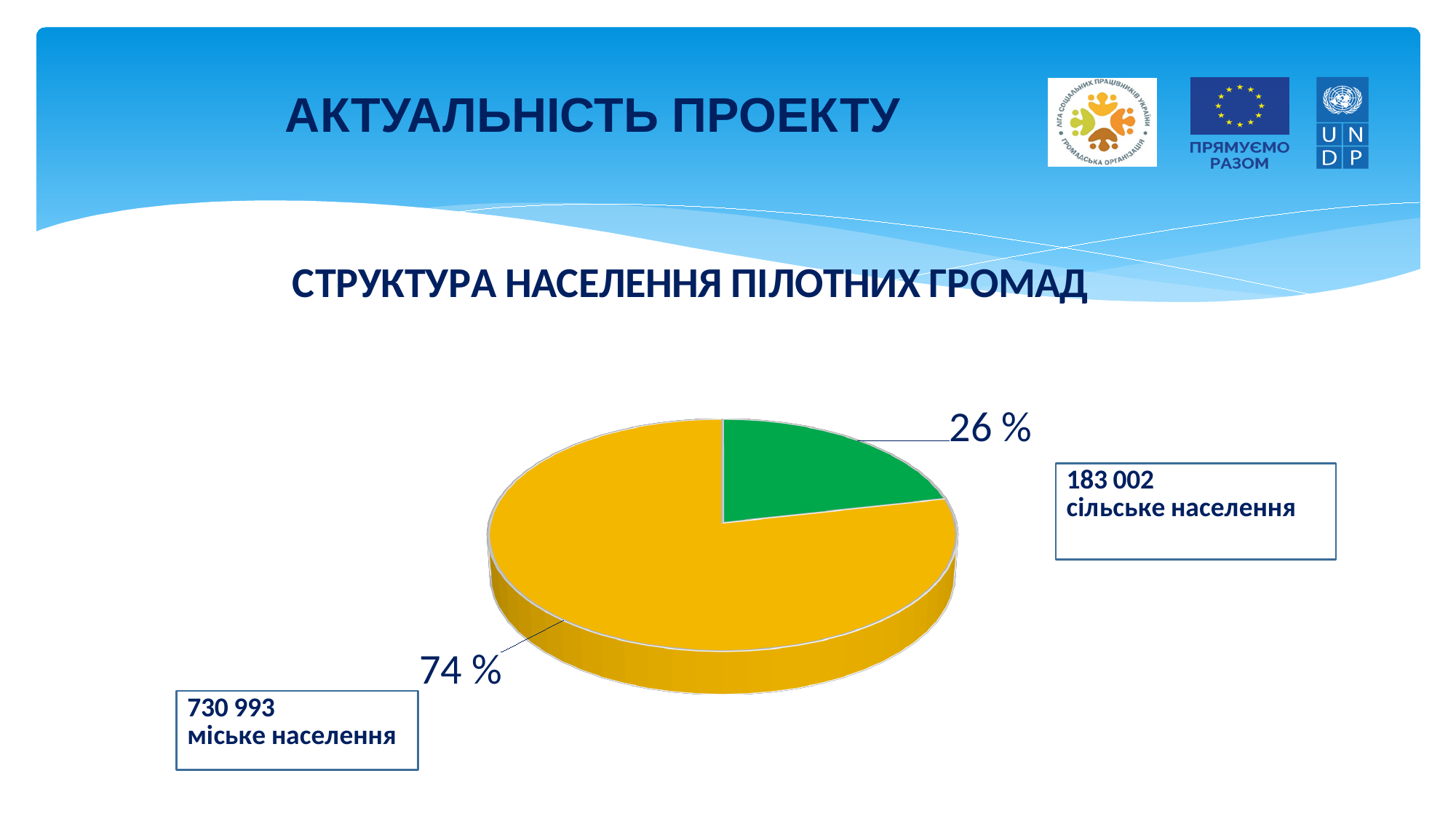
Which slice of the pie is the largest? міське населення What share of the pie does the urban population (міське населення) slice represent? 74 % By how many people does the urban population exceed the rural population? 547 991 What colour is the slice representing the rural population (сільське населення)? green What is the number of rural population (сільське населення) shown on the slide? 183 002 What is the difference in percentage points between the urban and rural population shares? 48 Which slice of the pie is the smallest? сільське населення Which is larger, the urban population or the rural population? міське населення What type of chart is shown on the slide? pie chart What share of the pie does the rural population (сільське населення) slice represent? 26 % What is the number of urban population (міське населення) shown on the slide? 730 993 How many slices does the pie chart have? 2